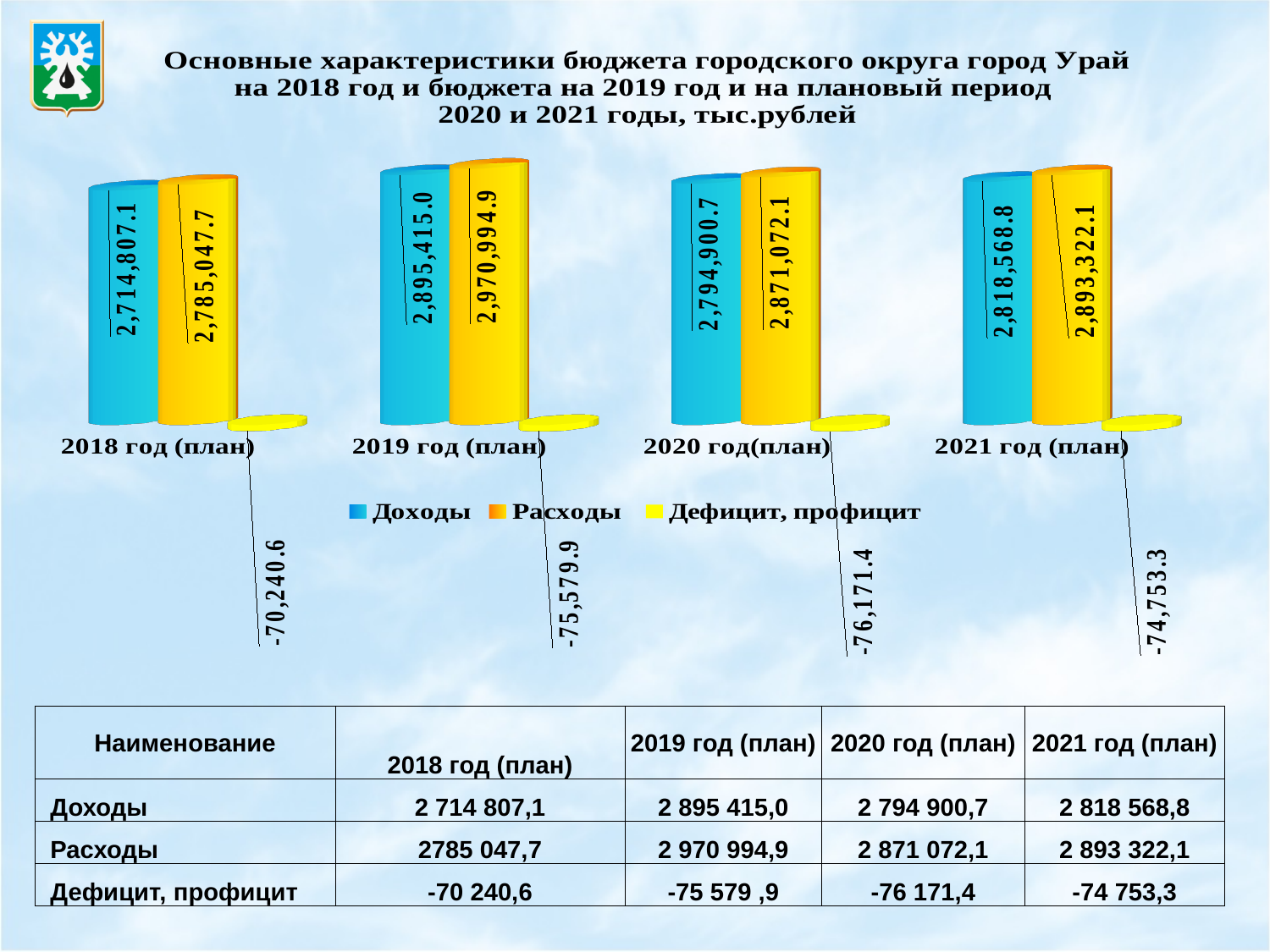
What is the difference between Расходы and Доходы for 2018 год (план)? 70,240.6 What is the value of Расходы for 2019 год (план)? 2,970,994.9 How many years (categories) are shown on the chart? 4 How many series does the legend list? 3 What is the value of Расходы for 2021 год (план)? 2,893,322.1 What is the value of Дефицит, профицит for 2020 год(план)? -76,171.4 In which year is Доходы the highest? 2019 год (план) What is the value of Доходы for 2018 год (план)? 2,714,807.1 In which year is Доходы the lowest? 2018 год (план) Which is larger for 2020 год(план): Доходы or Расходы? Расходы Which colour represents Доходы in the legend? Blue What kind of chart is shown on the slide? Bar chart